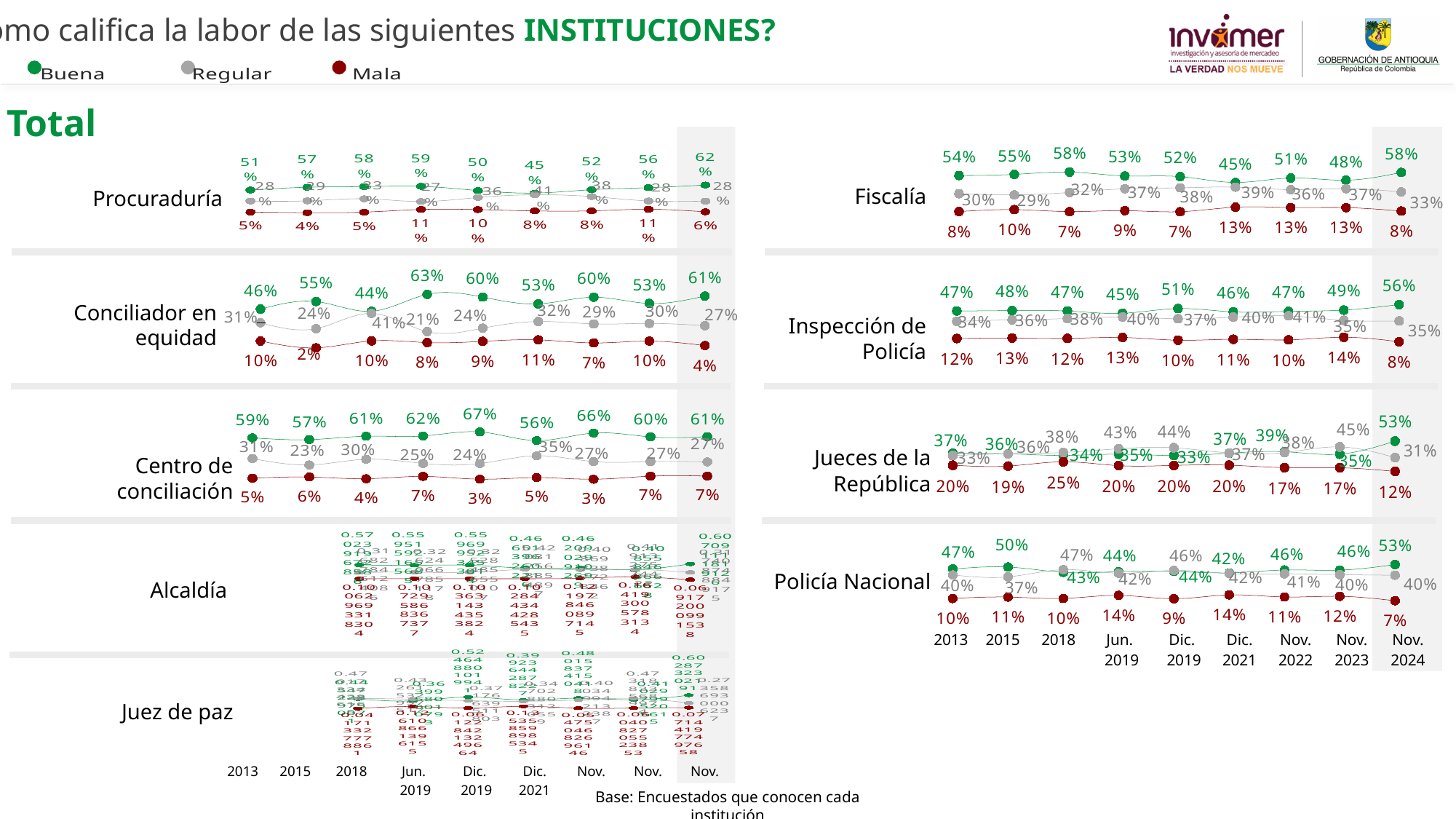
What kind of chart is used for each institution on the slide? Line chart In the Inspección de Policía chart, in which period is the Mala value lowest? Nov. 2024 How many time periods are plotted along the x axis of the Fiscalía chart? 9 Which colour represents the Mala series in the legend? Dark red In the Fiscalía chart, what is the Mala value for Dic. 2021? 13% In the Conciliador en equidad chart, which period has the larger Buena value, 2018 or Jun. 2019? Jun. 2019 In the Centro de conciliación chart, what is the difference between the Buena value in Dic. 2019 and in Dic. 2021? 11 percentage points In the Jueces de la República chart, in which period is the Mala value highest? 2018 How many series does the legend list? 3 In the Fiscalía chart, what is the Buena value for Nov. 2024? 58% In the Policía Nacional chart, what is the Mala value for Nov. 2024? 7% In the Jueces de la República chart, in which period is the Buena value highest? Nov. 2024